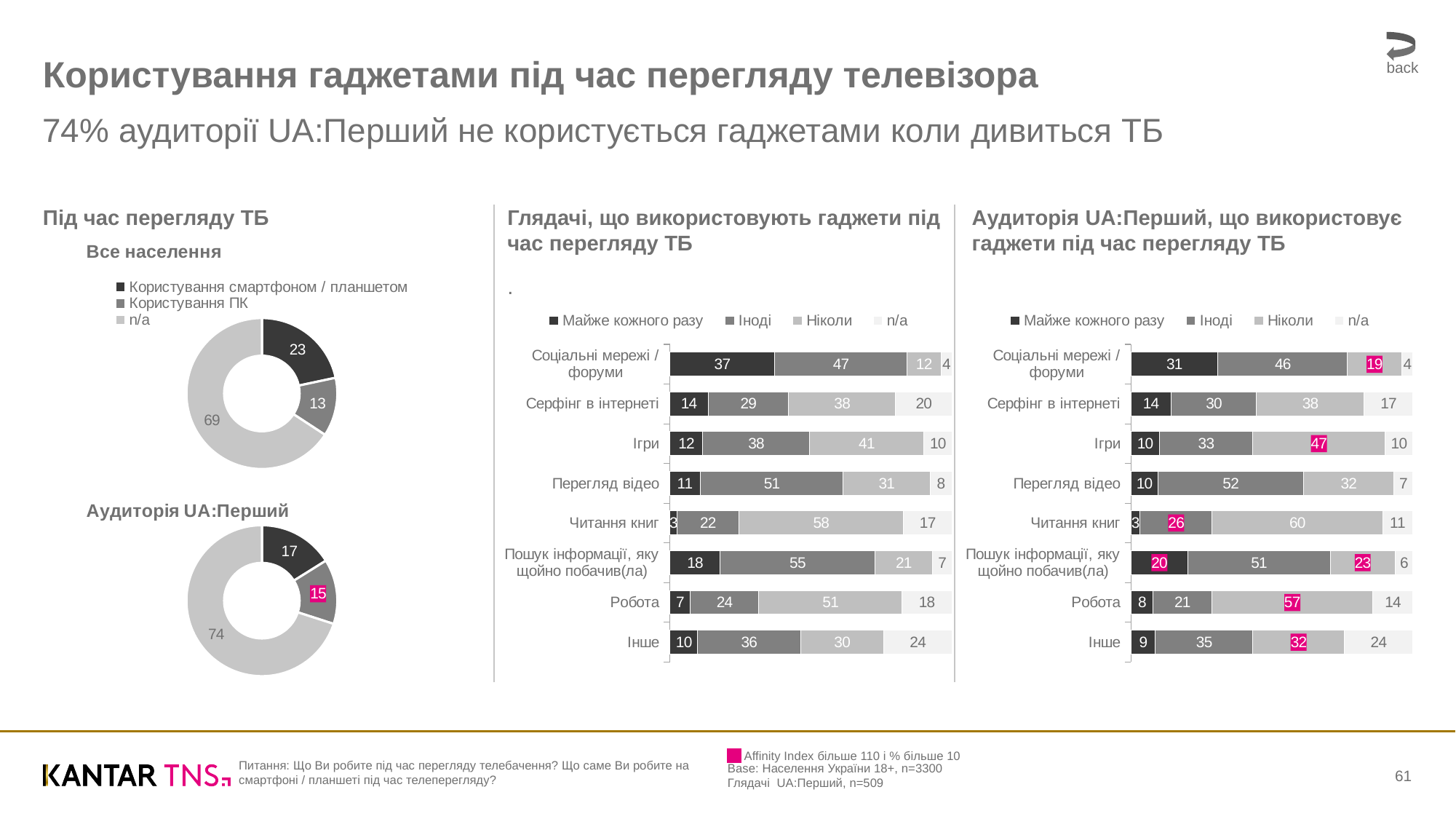
In the 'Аудиторія UA:Перший, що використовує гаджети під час перегляду ТБ' chart, what is the 'Ніколи' value for 'Робота'? 57 In the 'Все населення' donut chart, what is the difference between the 'n/a' value and the 'Користування ПК' value? 56 In the 'Глядачі, що використовують гаджети під час перегляду ТБ' chart, which category has the highest 'Майже кожного разу' value? Соціальні мережі / форуми In the 'Аудиторія UA:Перший, що використовує гаджети під час перегляду ТБ' chart, how many categories are shown? 8 In the 'Аудиторія UA:Перший, що використовує гаджети під час перегляду ТБ' chart, which category has the lowest 'Майже кожного разу' value? Читання книг In the 'Все населення' donut chart, what is the value for 'Користування смартфоном / планшетом'? 23 What kind of chart is used for 'Глядачі, що використовують гаджети під час перегляду ТБ'? Stacked bar chart In the 'Аудиторія UA:Перший' donut chart, what is the value for 'n/a'? 74 In the 'Глядачі, що використовують гаджети під час перегляду ТБ' chart, what is the 'Іноді' value for 'Перегляд відео'? 51 In the 'Глядачі, що використовують гаджети під час перегляду ТБ' chart, how many series does the legend list? 4 In the 'Аудиторія UA:Перший, що використовує гаджети під час перегляду ТБ' chart, is the 'Іноді' value for 'Перегляд відео' larger or smaller than the 'Іноді' value for 'Ігри'? larger In the 'Аудиторія UA:Перший' donut chart, what is the value for 'Користування ПК'? 15